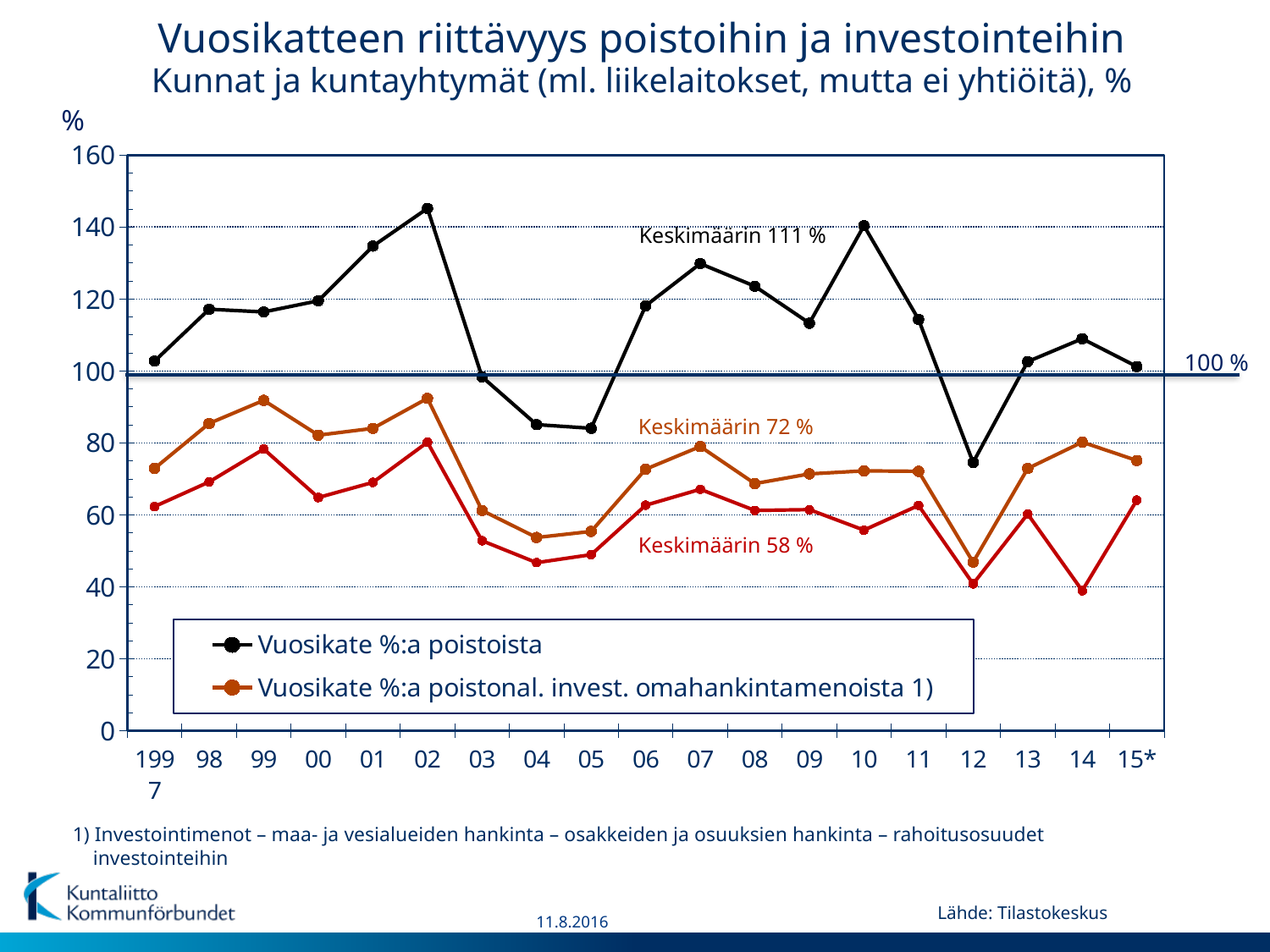
What kind of chart is shown on the slide? line chart Is the value for 'Vuosikate %:a poistoista' in 12 greater or less than 80? less Which is larger for 'Vuosikate %:a poistoista': the value in 01 or the value in 02? 02 How many series does the chart legend list? 2 In which year does the series 'Vuosikate %:a poistoista' reach its lowest value? 12 Is the value for 'Vuosikate %:a poistonal. invest. omahankintamenoista 1)' in 12 greater or less than 60? less In which year does the series 'Vuosikate %:a poistonal. invest. omahankintamenoista 1)' reach its lowest value? 12 What average value is annotated for the black series 'Vuosikate %:a poistoista'? Keskimäärin 111 % In which year does the series 'Vuosikate %:a poistoista' reach its highest value? 02 Does the series 'Vuosikate %:a poistoista' rise or fall from 1997 to 02? rise Is the value for 'Vuosikate %:a poistoista' in 02 greater or less than 140? greater How many years are plotted along the x axis? 19